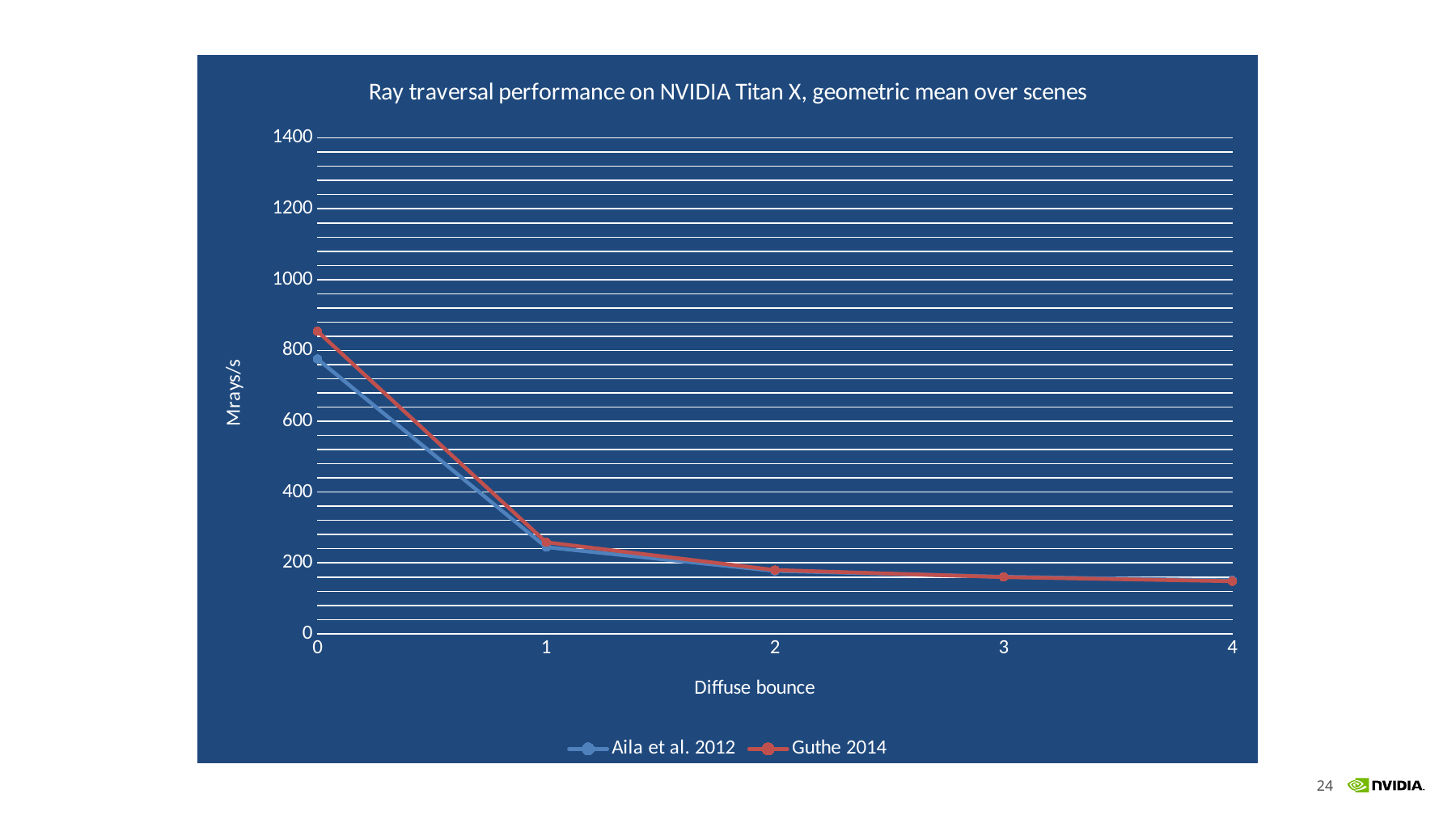
What is the title of the chart? Ray traversal performance on NVIDIA Titan X, geometric mean over scenes What is the label of the y axis? Mrays/s How many diffuse bounce values are plotted along the x axis? 5 At diffuse bounce 0, which series has the higher value, Aila et al. 2012 or Guthe 2014? Guthe 2014 What kind of chart is shown on the slide? line chart Do the values for Guthe 2014 rise or fall as the diffuse bounce increases? fall At which diffuse bounce is the value for Guthe 2014 highest? 0 Is the value for Aila et al. 2012 at diffuse bounce 1 greater or less than 400? less How many series does the legend list? 2 Is the value for Guthe 2014 at diffuse bounce 0 greater or less than 800? greater Is the value for Aila et al. 2012 at diffuse bounce 0 greater or less than 800? less